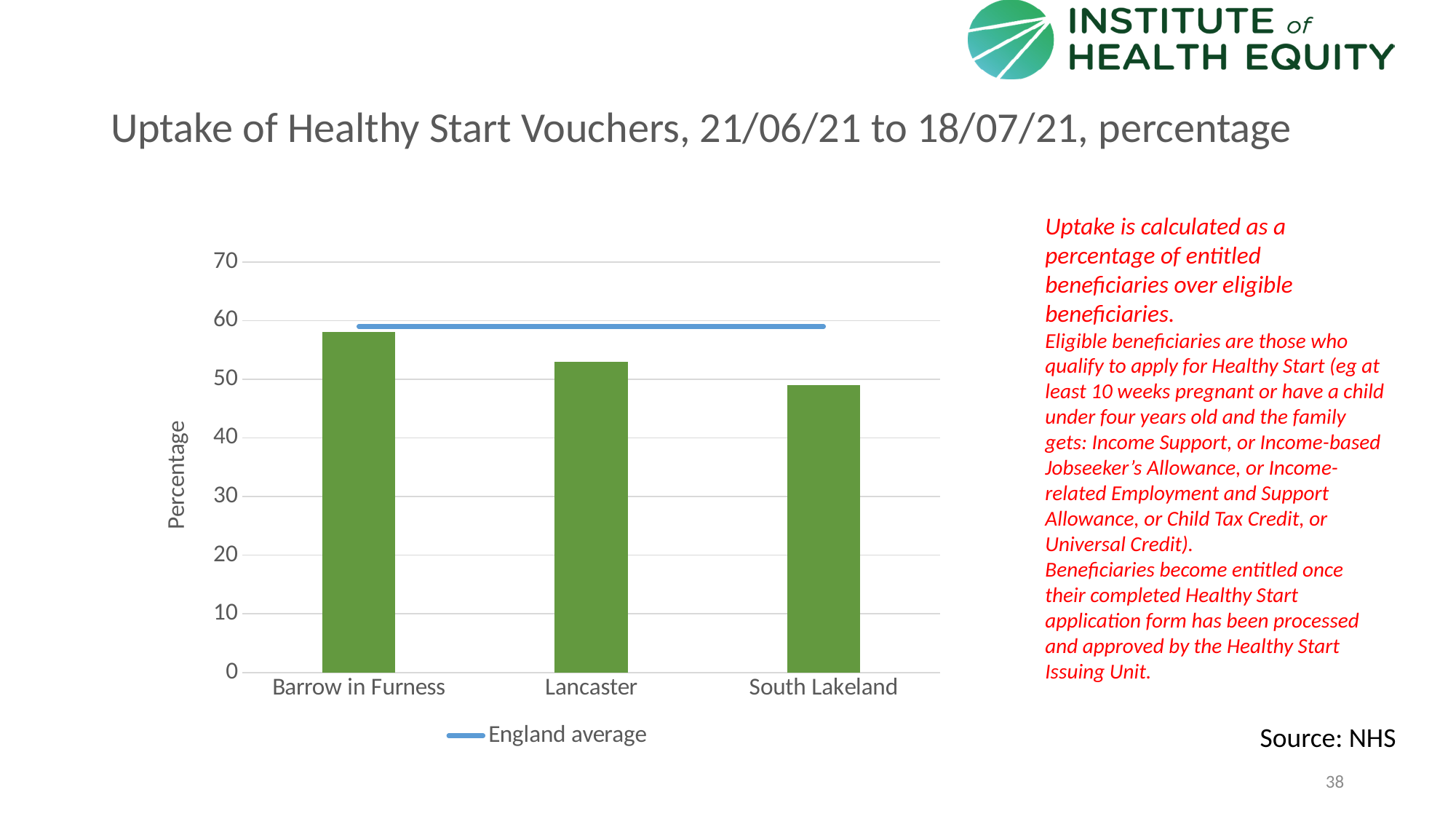
Do the bar values rise or fall moving from left to right across the x axis? Fall Is the value for Barrow in Furness greater or less than 50? greater Which area has the lowest uptake of Healthy Start vouchers? South Lakeland How many local areas are shown on the x axis of the chart? 3 How many entries does the chart legend list? 1 What does the blue horizontal line on the chart represent, according to the legend? England average Is the value for South Lakeland greater or less than 60? less Is the value for Lancaster greater or less than 60? less Which has the higher uptake, Lancaster or South Lakeland? Lancaster Which area has the highest uptake of Healthy Start vouchers? Barrow in Furness What kind of chart is shown on the slide? Combination bar and line chart (bars with a horizontal line for the England average)